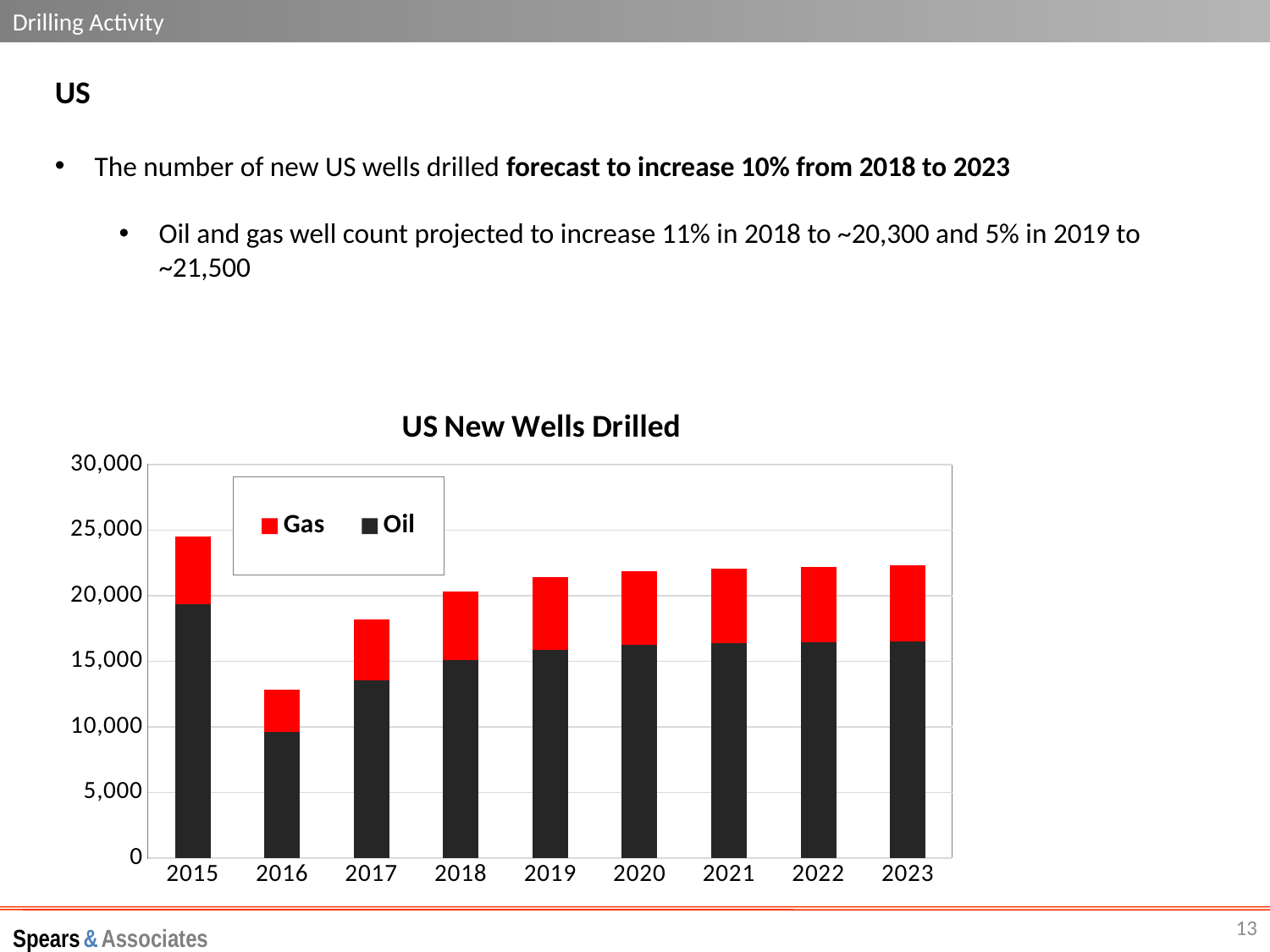
Is the total number of new wells drilled in 2015 greater or less than 20,000? greater Is the total number of new wells drilled in 2017 greater or less than 20,000? less Which year has the highest total of new wells drilled in the 'US New Wells Drilled' chart? 2015 Which year has the larger total of new wells drilled, 2017 or 2018? 2018 How many years are shown on the x axis of the 'US New Wells Drilled' chart? 9 Which year has the lowest total of new wells drilled in the 'US New Wells Drilled' chart? 2016 Which series are shown in the legend of the 'US New Wells Drilled' chart? Gas and Oil How many series does the legend of the 'US New Wells Drilled' chart list? 2 Do the total new wells drilled rise or fall from 2016 to 2023? rise Is the total number of new wells drilled in 2016 greater or less than 15,000? less What type of chart is 'US New Wells Drilled'? stacked bar chart